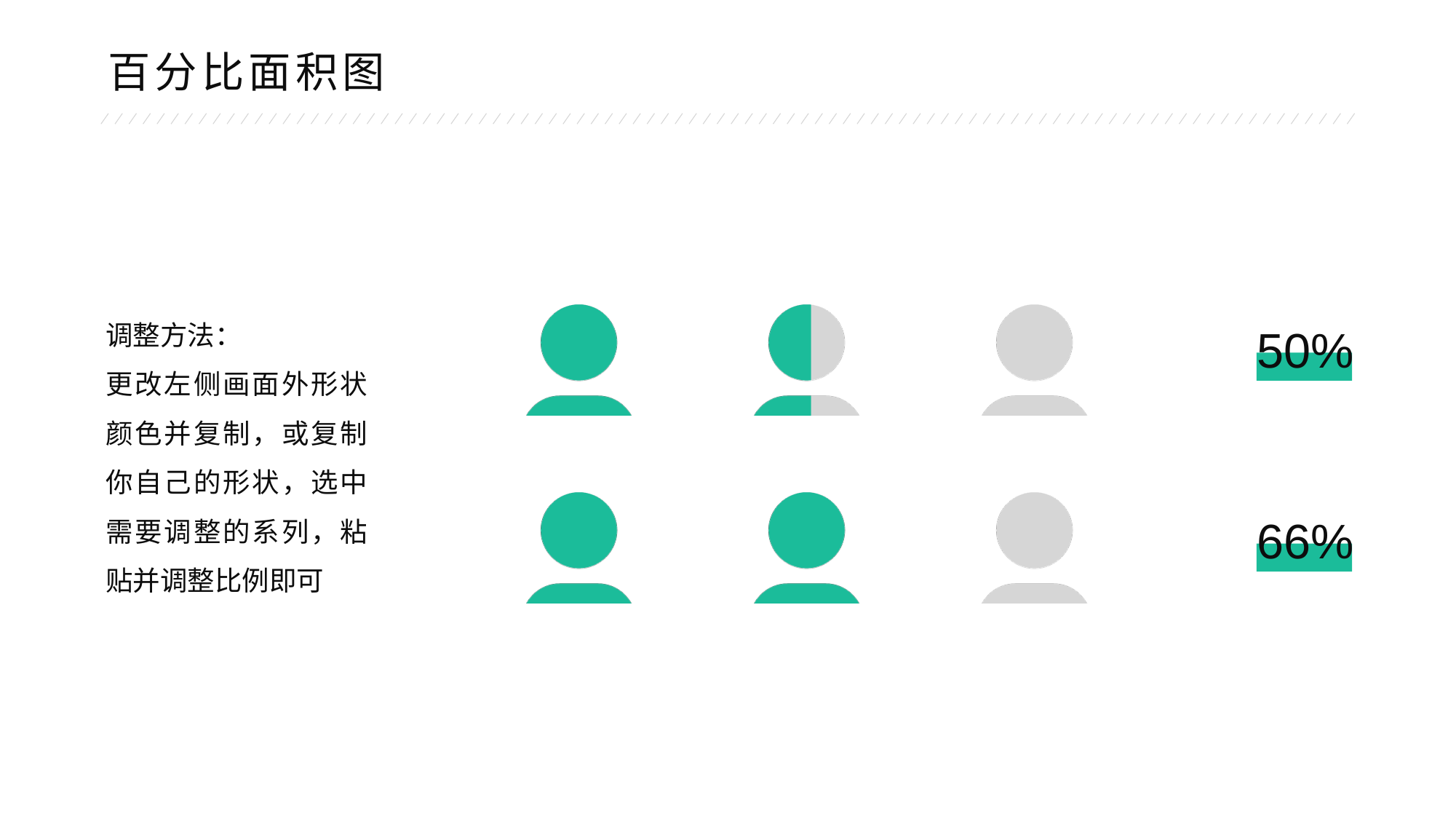
What is the difference between the bottom row's percentage and the top row's percentage? 16% Which row of person icons has the lower percentage, the top or the bottom? top How many rows of person icons are shown on the slide? 2 How many person icons are shown in total on the slide? 6 Is the percentage for the bottom row larger or smaller than the percentage for the top row? larger What percentage is shown for the top row of person icons? 50% Which row of person icons has the higher percentage, the top or the bottom? bottom What colour is used for the filled portion of the person icons? green How many person icons are in each row? 3 What is the title of the slide? 百分比面积图 What percentage is shown for the bottom row of person icons? 66% What kind of chart is shown on the slide? pictogram (icon) chart